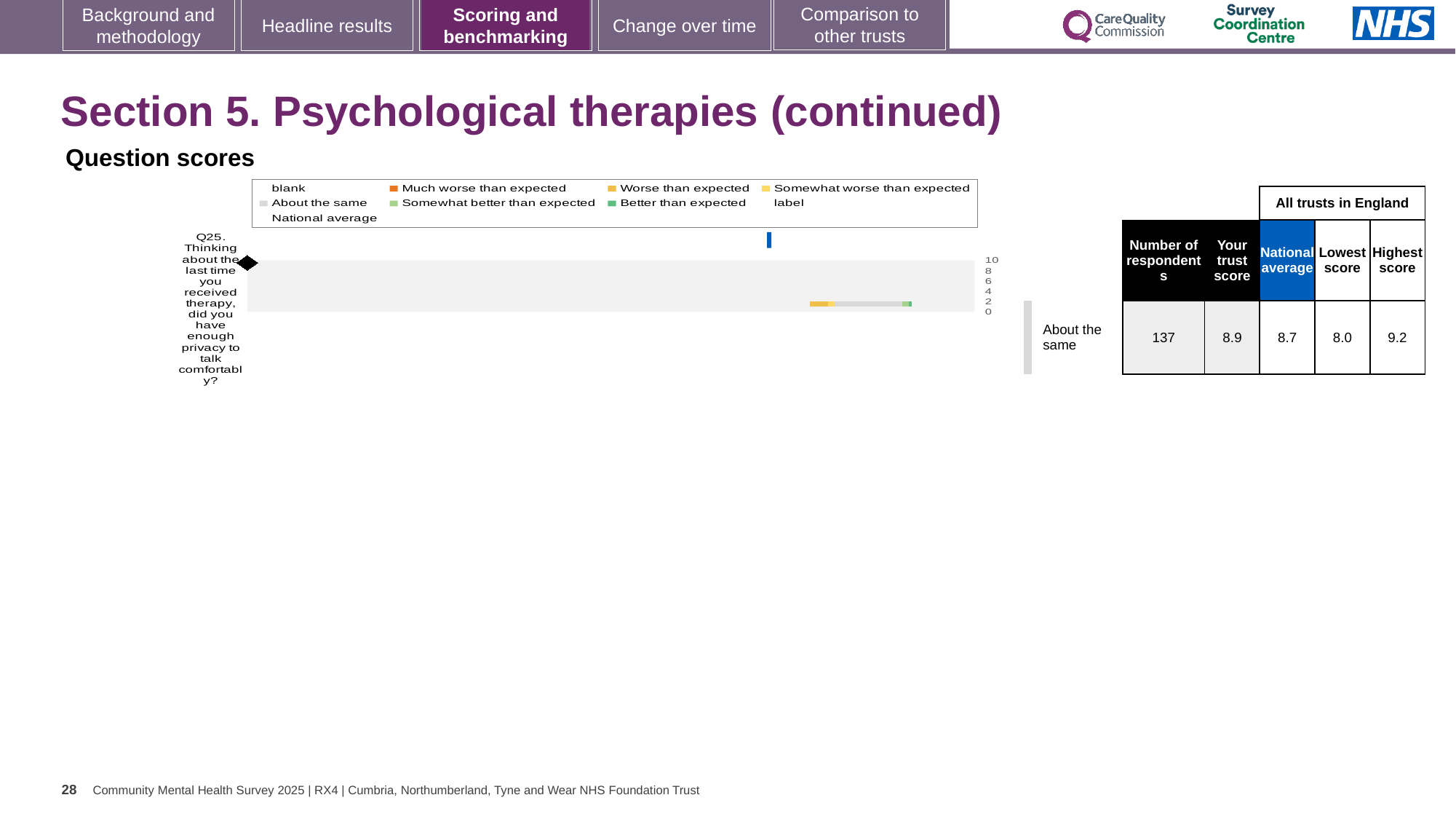
What is the trust score for Q25 shown in the table? 8.9 How many respondents answered Q25? 137 Which question is plotted in the Question scores chart? Q25. Thinking about the last time you received therapy, did you have enough privacy to talk comfortably? What is the lowest score among all trusts in England for Q25? 8.0 What is the national average for Q25 shown in the table? 8.7 What is the highest score among all trusts in England for Q25? 9.2 For Q25, which is larger: the trust score or the national average? Your trust score What kind of chart is shown under 'Question scores'? bar chart Which benchmark category is Q25 assigned to, according to the label next to the chart? About the same What is the difference between the highest score and the lowest score for Q25? 1.2 How many questions (categories) are plotted in the Question scores chart? 1 What is the difference between the trust score and the national average for Q25? 0.2